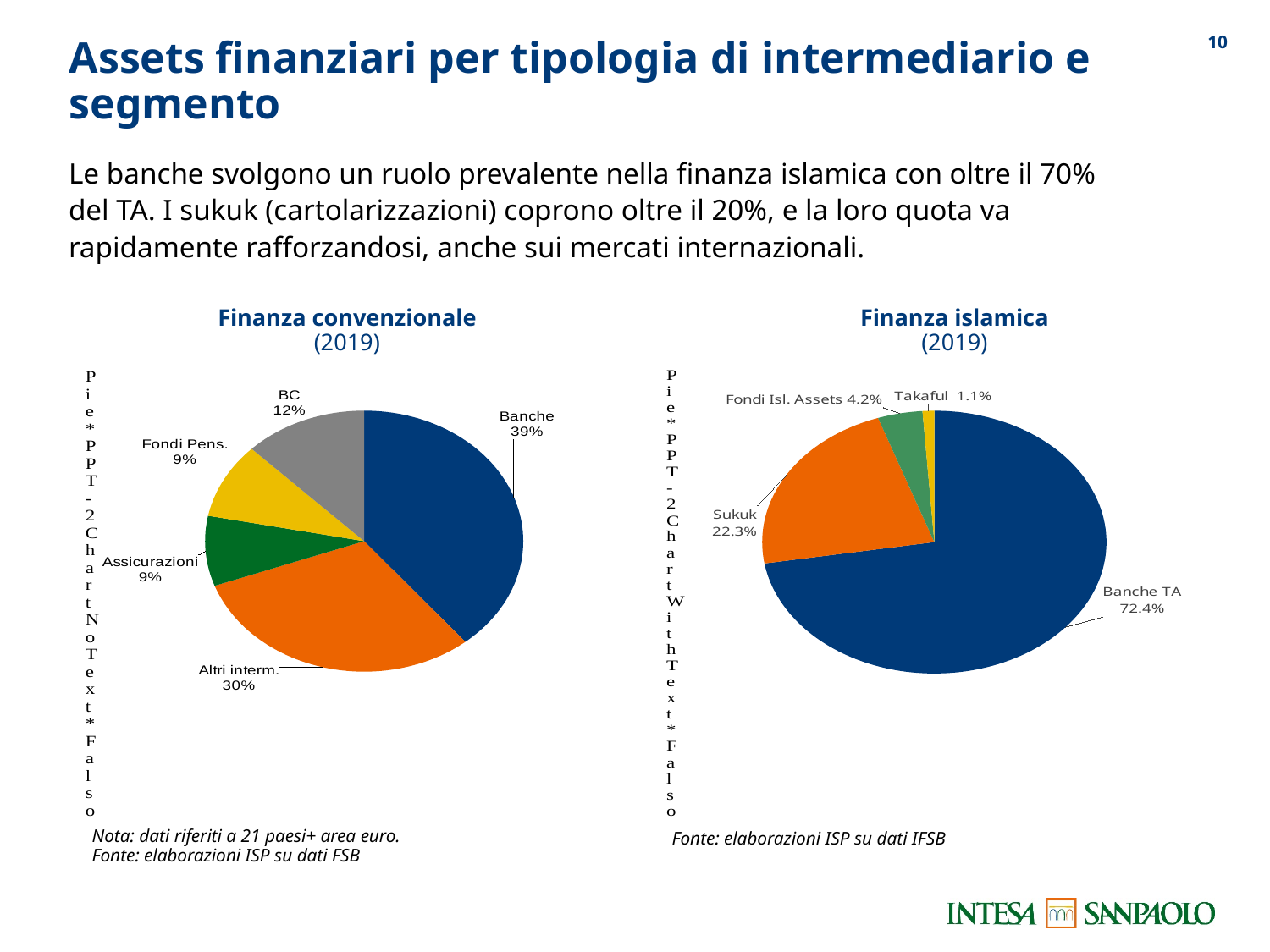
In the 'Finanza islamica' chart, what share do Banche TA hold? 72.4% In the 'Finanza convenzionale' chart, which category has the largest slice? Banche In the 'Finanza convenzionale' chart, what share do Banche hold? 39% What type of chart is used for 'Finanza islamica'? Pie chart In the 'Finanza convenzionale' chart, what is the difference between the Banche share and the Altri interm. share? 9 percentage points In the 'Finanza convenzionale' chart, what is the share of Altri interm.? 30% In the 'Finanza convenzionale' chart, what is the share of BC? 12% In the 'Finanza islamica' chart, which is larger: Fondi Isl. Assets or Takaful? Fondi Isl. Assets In the 'Finanza islamica' chart, which category has the smallest slice? Takaful In the 'Finanza islamica' chart, how many slices does the pie have? 4 In the 'Finanza convenzionale' chart, how many slices does the pie have? 5 In the 'Finanza islamica' chart, what is the share of Sukuk? 22.3%